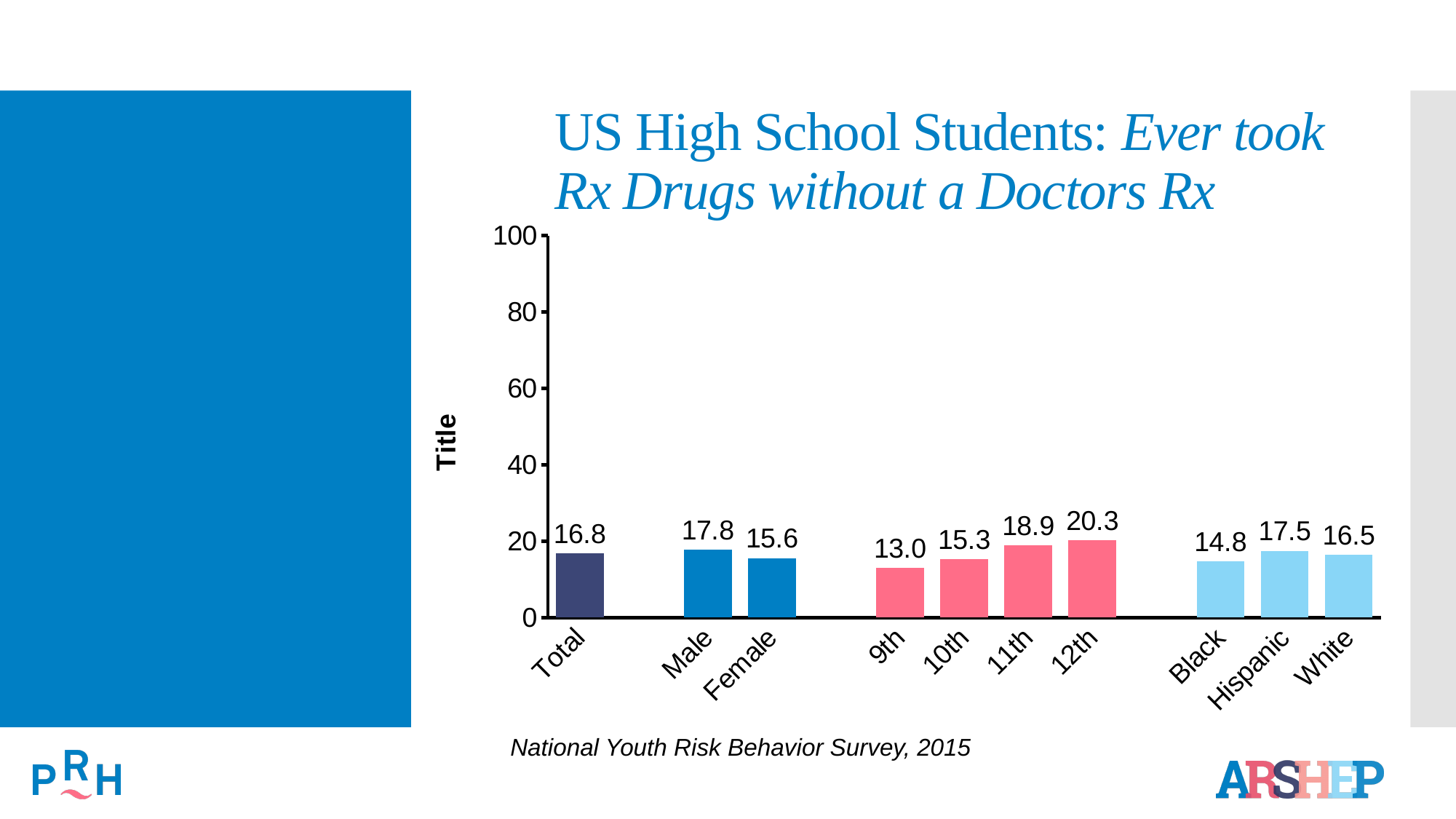
What is the value for Total? 16.8 Do the values rise or fall from 9th to 12th grade? rise What kind of chart is this? bar chart Which is larger, the value for Black or the value for White? White What is the value for Hispanic students? 17.5 What is the source cited below the chart? National Youth Risk Behavior Survey, 2015 What is the difference between the Male and Female values? 2.2 Is the value for 11th graders greater or less than 20? less Which category has the highest value? 12th Which category has the lowest value? 9th How many categories are shown on the x axis? 10 What is the value for 12th graders? 20.3